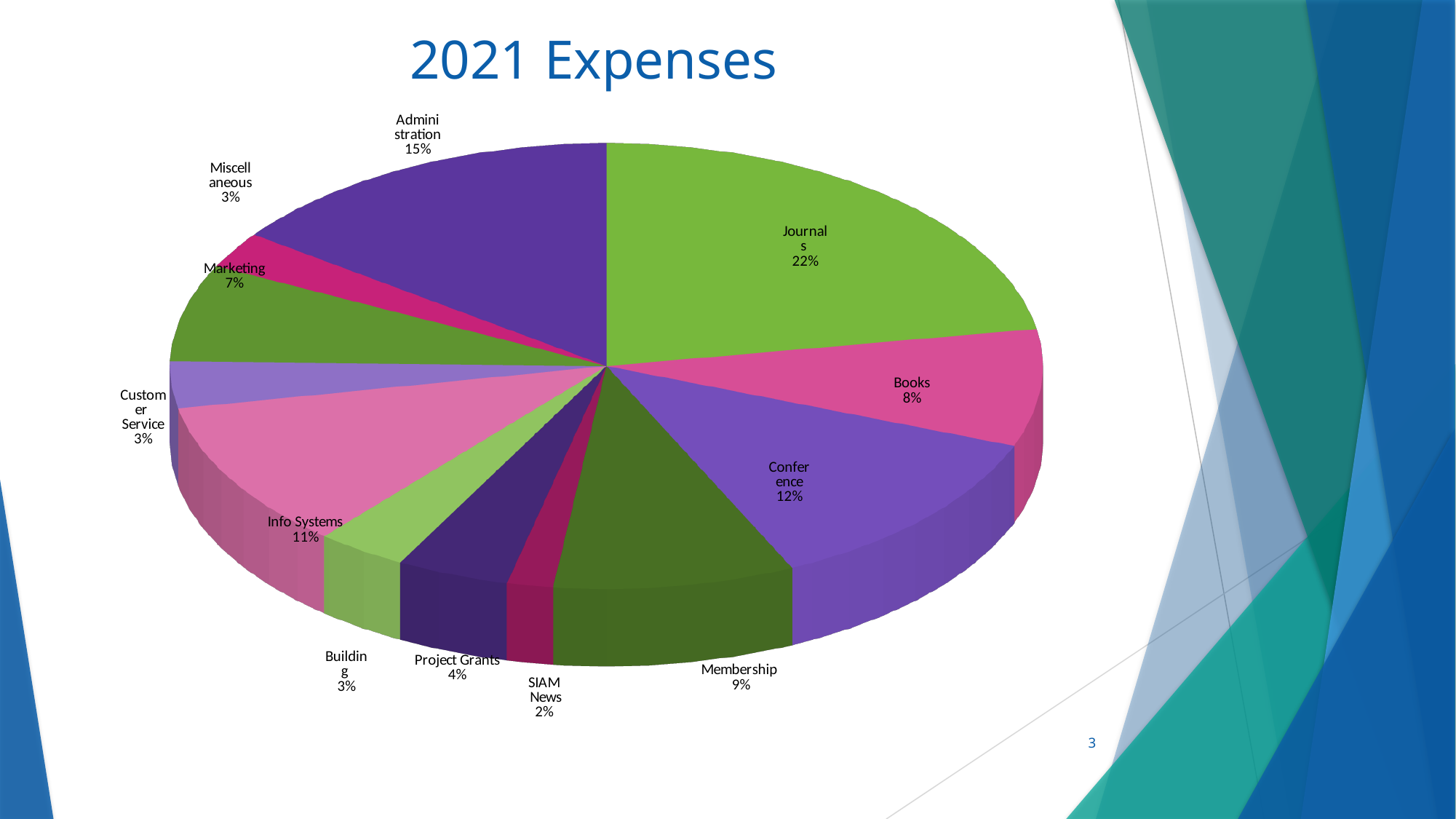
Which category has the largest share of 2021 expenses? Journals What percentage of the pie is Administration? 15% What is the value shown for Info Systems? 11% What is the difference in percentage points between Journals and Conference? 10 What is the title of the chart? 2021 Expenses How many categories are shown in the pie chart? 12 What share of 2021 expenses is Journals? 22% Which is larger, Books or Membership? Membership What kind of chart is shown on the slide? Pie chart Which category has the smallest share of 2021 expenses? SIAM News Which is larger, Marketing or Project Grants? Marketing What percentage is shown for SIAM News? 2%